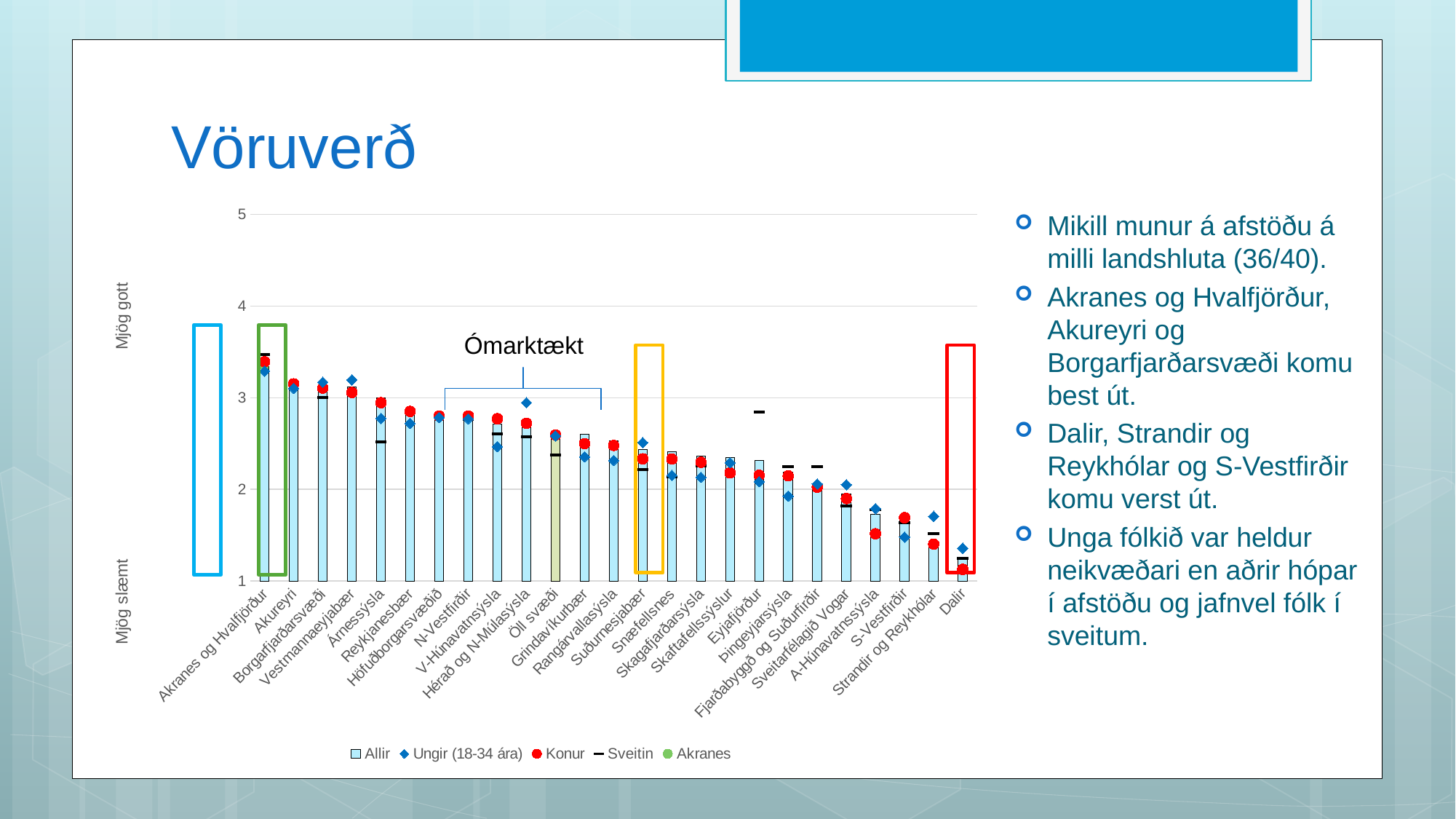
How many series does the chart legend list? 5 Which region has the highest 'Allir' bar in the chart? Akranes og Hvalfjörður Do the 'Allir' bar values generally rise or fall from left to right along the x axis? fall What kind of chart is shown on the slide? bar chart Is the 'Allir' value for Akranes og Hvalfjörður greater or less than 3? greater Which has the larger 'Allir' value, Akureyri or Dalir? Akureyri Is the 'Allir' value for Dalir greater or less than 2? less What annotation text is written above the bracketed group of bars in the middle of the chart? Ómarktækt Which region has the lowest 'Allir' bar in the chart? Dalir What are the five series named in the chart legend? Allir, Ungir (18-34 ára), Konur, Sveitin, Akranes Is the 'Allir' value for Strandir og Reykhólar greater or less than 2? less How many regions (categories) are plotted along the x axis of the chart? 25